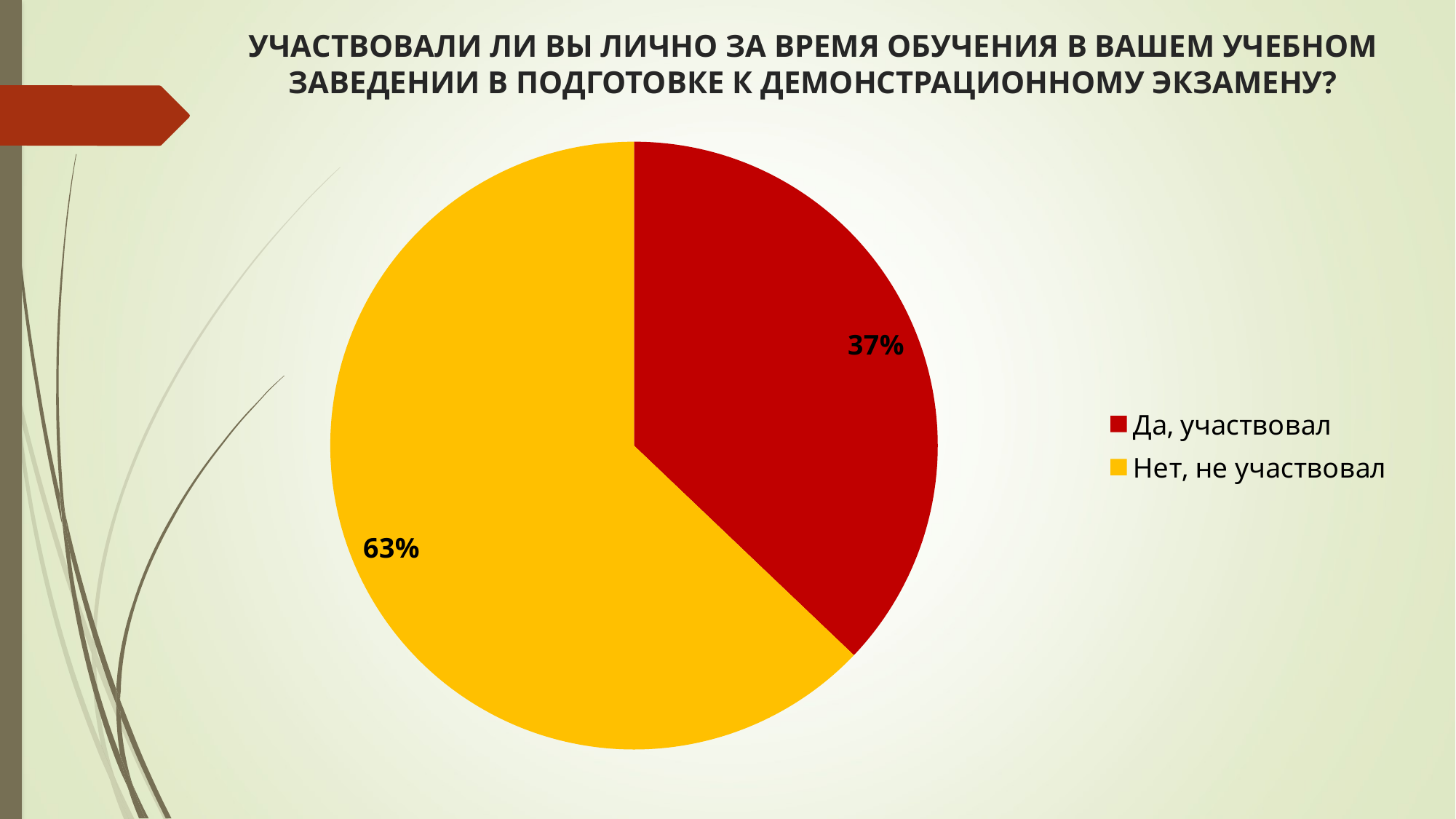
Which category has the largest slice of the pie? Нет, не участвовал How many slices does the pie chart have? 2 What colour is the slice for "Нет, не участвовал"? yellow What colour is the slice for "Да, участвовал"? red Is the share for "Да, участвовал" greater or less than 50%? less Which category has the smallest slice of the pie? Да, участвовал What share of the pie is labelled "Нет, не участвовал"? 63% How many entries does the legend list? 2 What share of the pie is labelled "Да, участвовал"? 37% What kind of chart is shown on the slide? pie chart Which slice is larger: "Да, участвовал" or "Нет, не участвовал"? Нет, не участвовал What is the difference in percentage points between the "Нет, не участвовал" slice and the "Да, участвовал" slice? 26